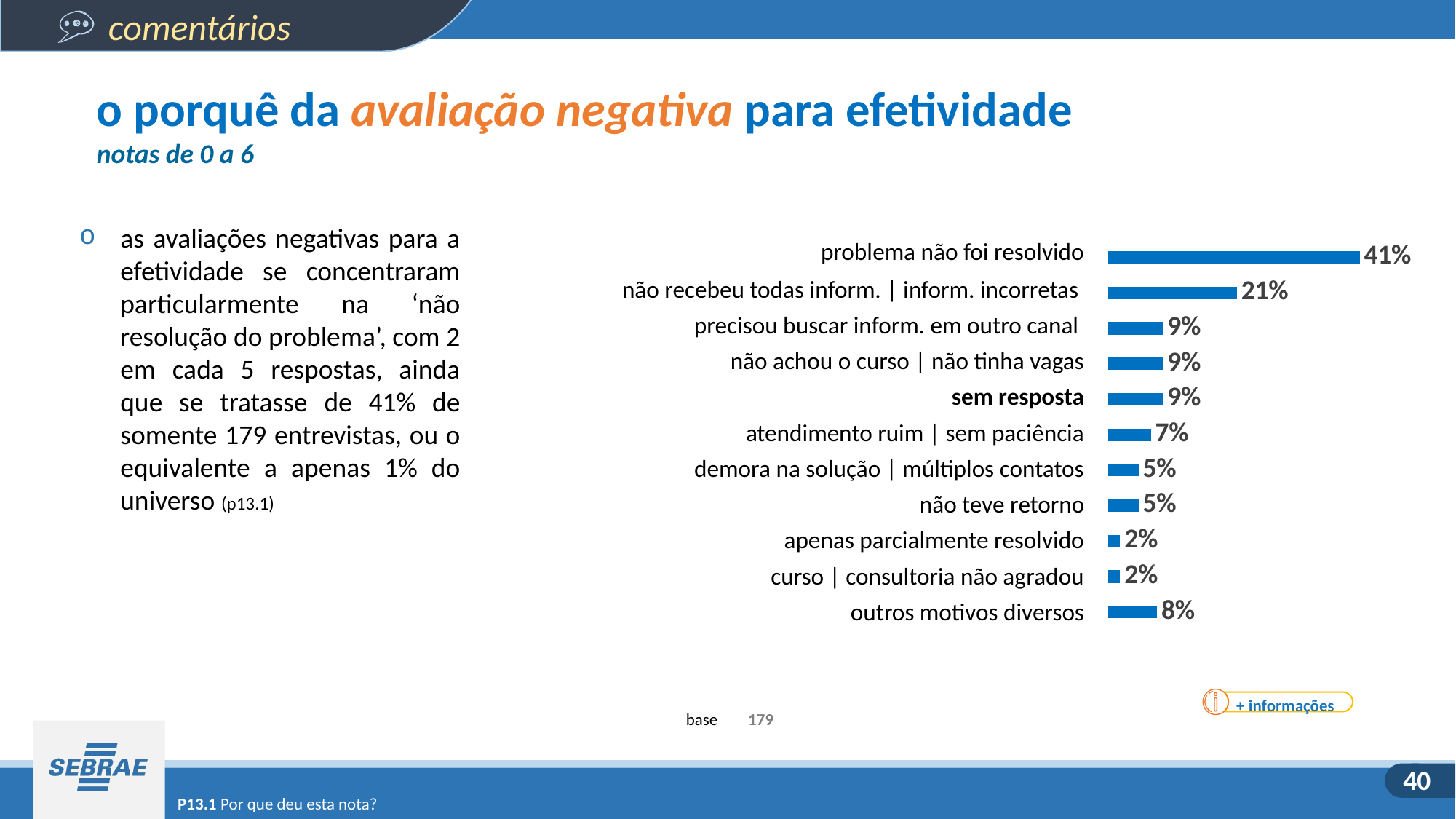
Which is larger: 'demora na solução | múltiplos contatos' or 'outros motivos diversos'? outros motivos diversos What is the value for 'atendimento ruim | sem paciência'? 7% What is the difference between 'problema não foi resolvido' and 'não recebeu todas inform. | inform. incorretas'? 20% What is the value for 'problema não foi resolvido'? 41% What is the value for 'sem resposta'? 9% What base (number of respondents) is shown below the chart? 179 What kind of chart is shown on the slide? bar chart What is the difference between 'precisou buscar inform. em outro canal' and 'não teve retorno'? 4% What is the value for 'não recebeu todas inform. | inform. incorretas'? 21% How many categories are shown in the chart? 11 Which category has the highest value? problema não foi resolvido What is the value for 'outros motivos diversos'? 8%